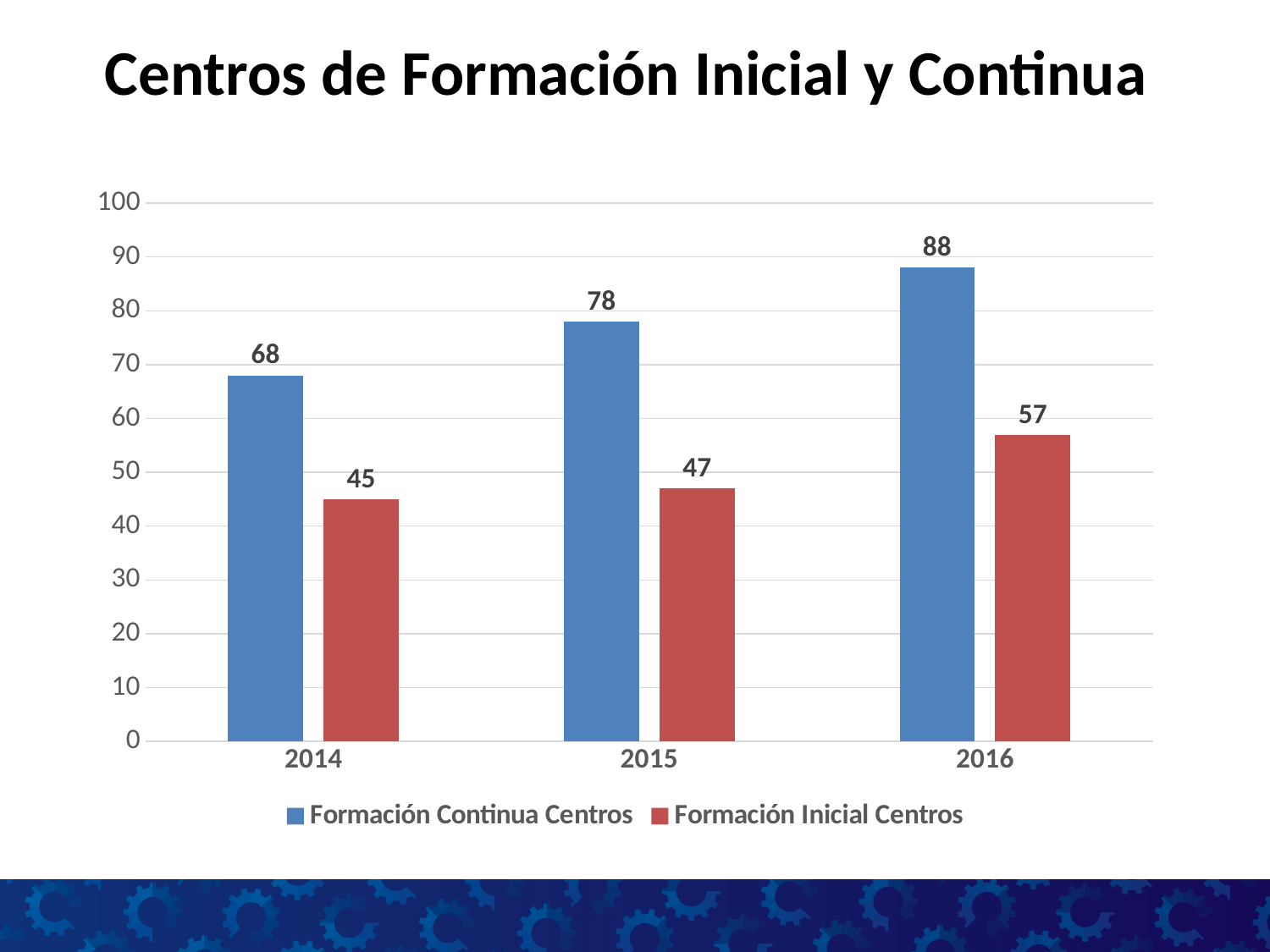
How many years are shown on the x axis? 3 Is the value for Formación Continua Centros in 2015 greater or less than 70? greater What kind of chart is shown on the slide? bar chart How many series does the legend list? 2 Do the values for Formación Continua Centros rise or fall from 2014 to 2016? rise What is the value for Formación Inicial Centros in 2016? 57 Which is larger in 2015: Formación Continua Centros or Formación Inicial Centros? Formación Continua Centros What is the difference between Formación Continua Centros and Formación Inicial Centros in 2016? 31 In which year is Formación Inicial Centros lowest? 2014 What is the value for Formación Continua Centros in 2014? 68 In which year is Formación Continua Centros highest? 2016 What is the value for Formación Inicial Centros in 2015? 47